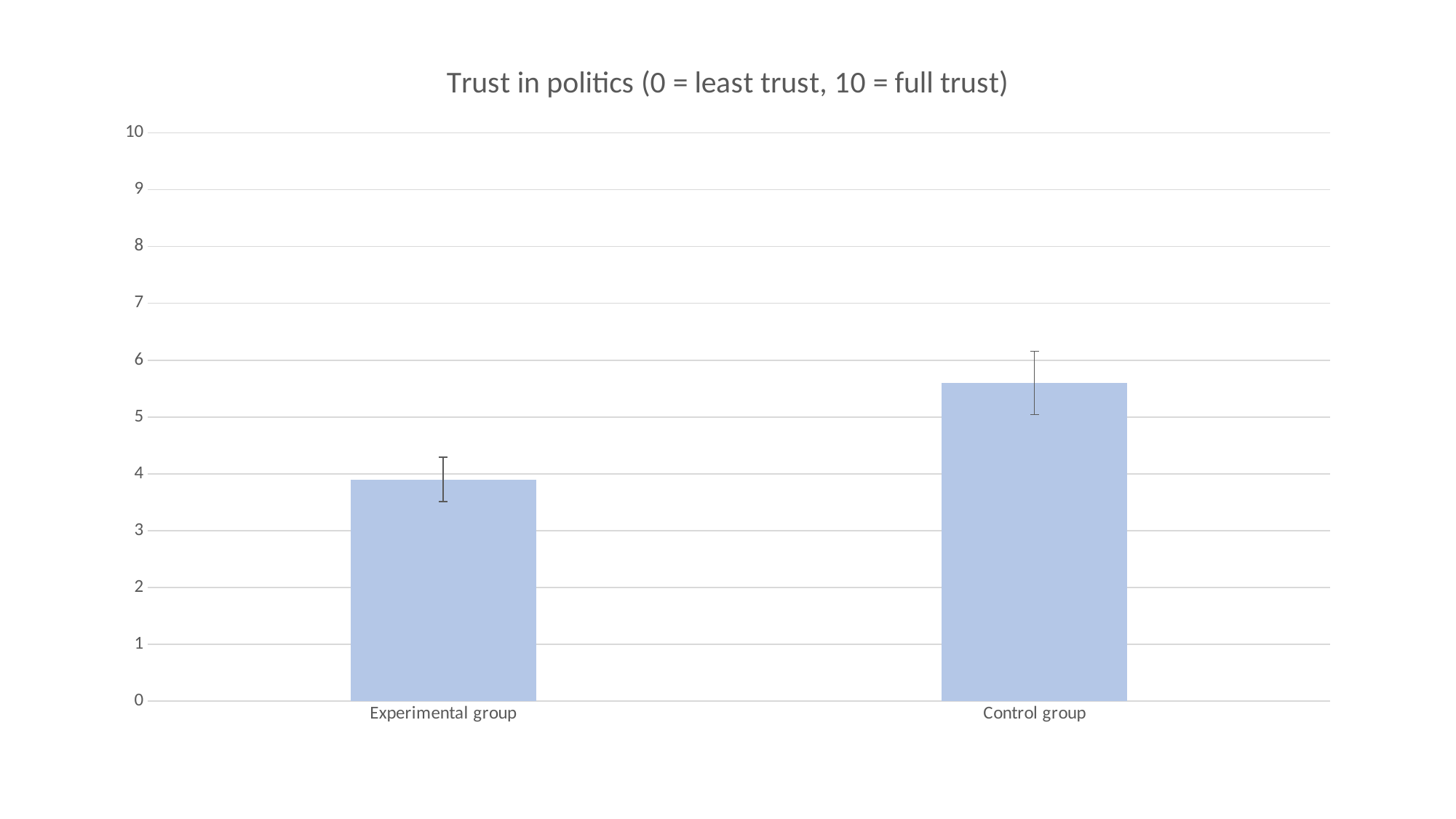
Which group has the highest trust in politics value? Control group Which group has the lowest trust in politics value? Experimental group Is the value for the Experimental group greater or less than 3? greater What kind of chart is shown on the slide? bar chart Is the value for the Control group greater or less than 6? less What is the maximum value shown on the vertical axis? 10 How many categories are plotted in the chart? 2 What is the title of the chart? Trust in politics (0 = least trust, 10 = full trust) Which is larger, the value for the Experimental group or the Control group? Control group Is the value for the Control group greater or less than 5? greater